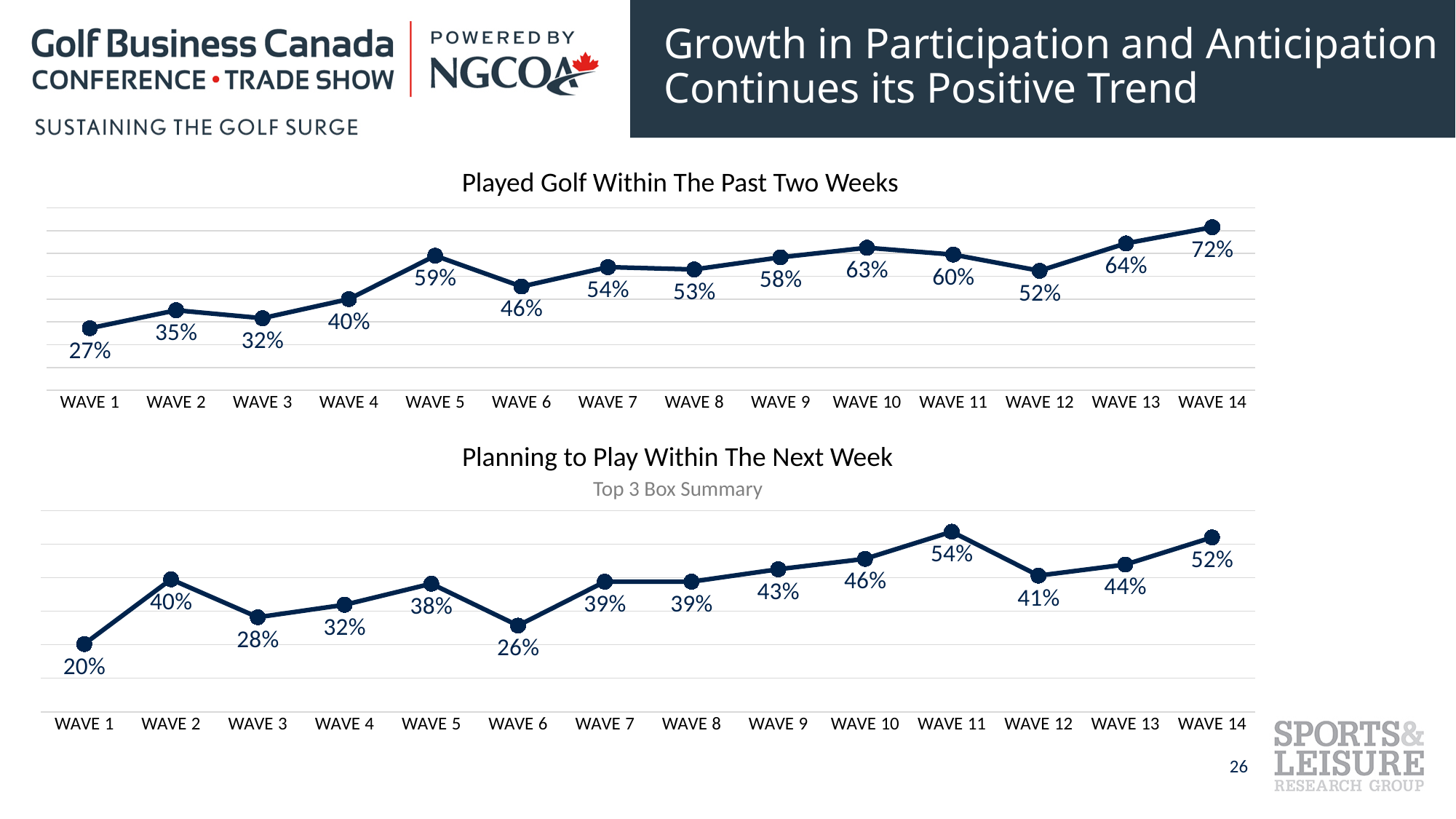
In the 'Played Golf Within The Past Two Weeks' chart, which wave has the lowest value? Wave 1 What type of chart is the 'Played Golf Within The Past Two Weeks' chart? Line chart In the 'Played Golf Within The Past Two Weeks' chart, what is the difference between Wave 14 and Wave 1? 45% In the 'Planning to Play Within The Next Week' chart, which wave has the lowest value? Wave 1 What is the subtitle shown under the 'Planning to Play Within The Next Week' chart title? Top 3 Box Summary In the 'Planning to Play Within The Next Week' chart, what is the value for Wave 11? 54% In the 'Planning to Play Within The Next Week' chart, what is the difference between Wave 12 and Wave 11? 13% In the 'Played Golf Within The Past Two Weeks' chart, how many waves are plotted? 14 In the 'Played Golf Within The Past Two Weeks' chart, which wave has the highest value? Wave 14 In the 'Planning to Play Within The Next Week' chart, which wave has the highest value? Wave 11 In the 'Planning to Play Within The Next Week' chart, which is larger, Wave 2 or Wave 6? Wave 2 In the 'Played Golf Within The Past Two Weeks' chart, what is the value for Wave 5? 59%